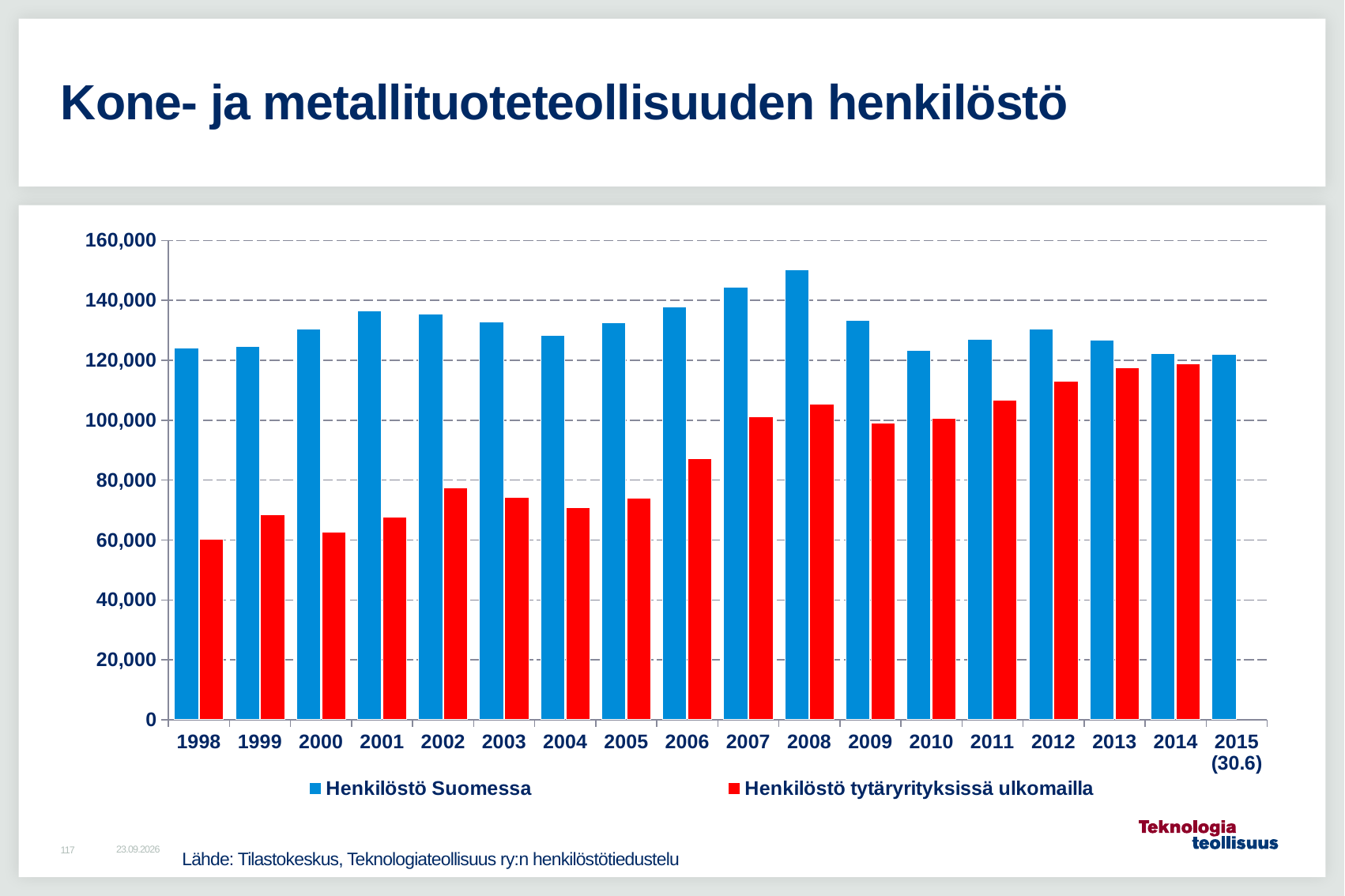
Does the value for Henkilöstö tytäryrityksissä ulkomailla generally rise or fall from 1998 to 2014? rise In which year is the value for Henkilöstö Suomessa highest? 2008 In which year is the value for Henkilöstö tytäryrityksissä ulkomailla lowest? 1998 Which is larger for Henkilöstö tytäryrityksissä ulkomailla: the value in 1998 or the value in 2014? 2014 How many years (categories) are shown on the x axis? 18 How many series does the legend list? 2 Is the value for Henkilöstö Suomessa in 2008 greater or less than 140,000? greater Is the value for Henkilöstö tytäryrityksissä ulkomailla in 2012 greater or less than 100,000? greater What kind of chart is shown on the slide? bar chart Is the value for Henkilöstö tytäryrityksissä ulkomailla in 1998 greater or less than 80,000? less Which is larger for Henkilöstö Suomessa: the value in 2007 or the value in 2009? 2007